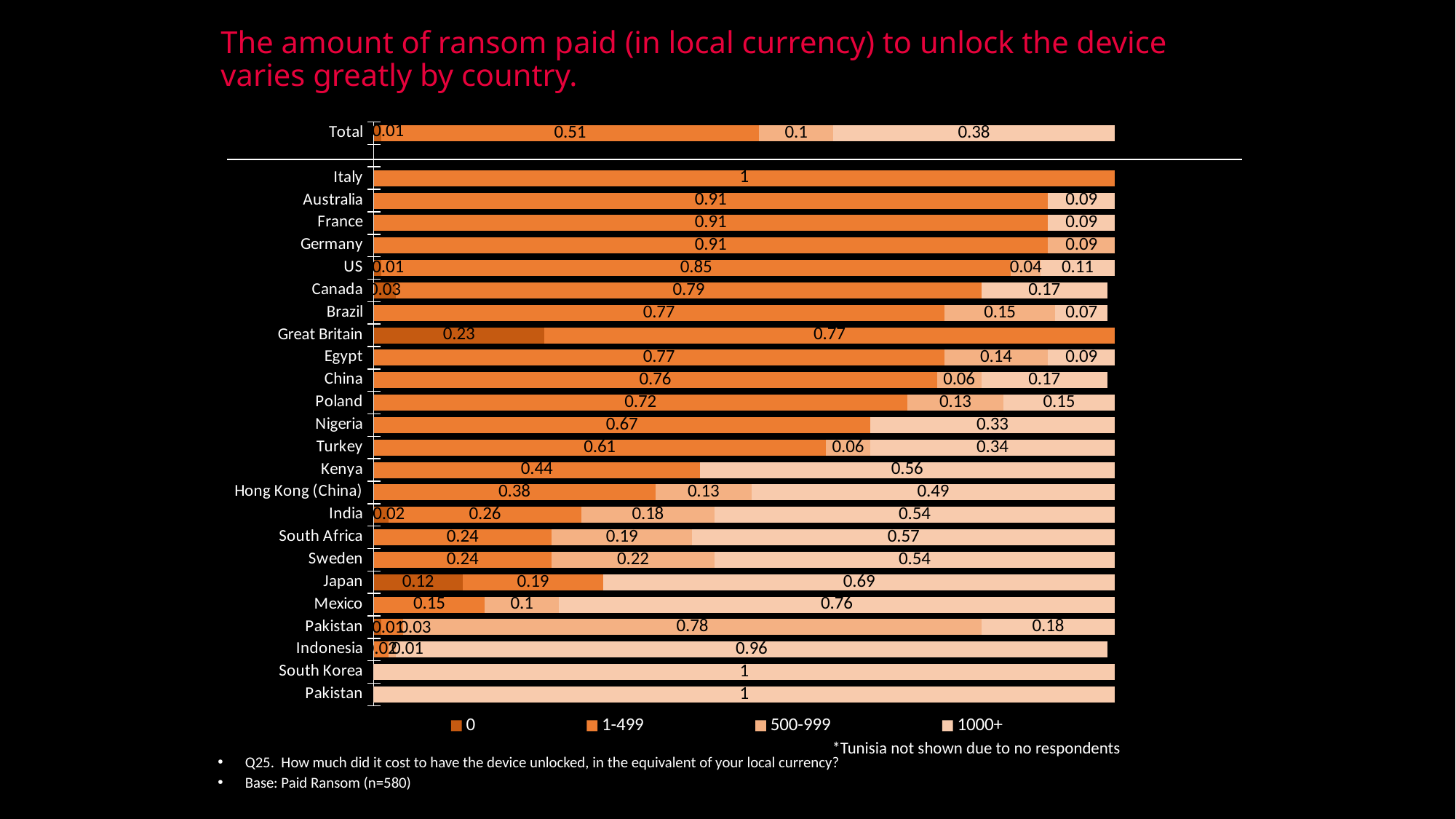
What are the legend entries of the chart? 0, 1-499, 500-999, 1000+ What type of chart is shown on the slide? Stacked bar chart How many series does the legend list? 4 What is the value of the 0 segment for Great Britain? 0.23 What is the value of the 1-499 segment for Italy? 1 What is the value of the 1000+ segment for Nigeria? 0.33 What is the value of the 1-499 segment in the Total bar? 0.51 What is the total of the stacked Total bar (0.01, 0.51, 0.1 and 0.38)? 1 Which country has the highest value for the 0 segment? Great Britain What is the value of the 1000+ segment for Japan? 0.69 For Kenya, which segment is larger: 1-499 or 1000+? 1000+ For Nigeria, what is the difference between the 1-499 segment and the 1000+ segment? 0.34